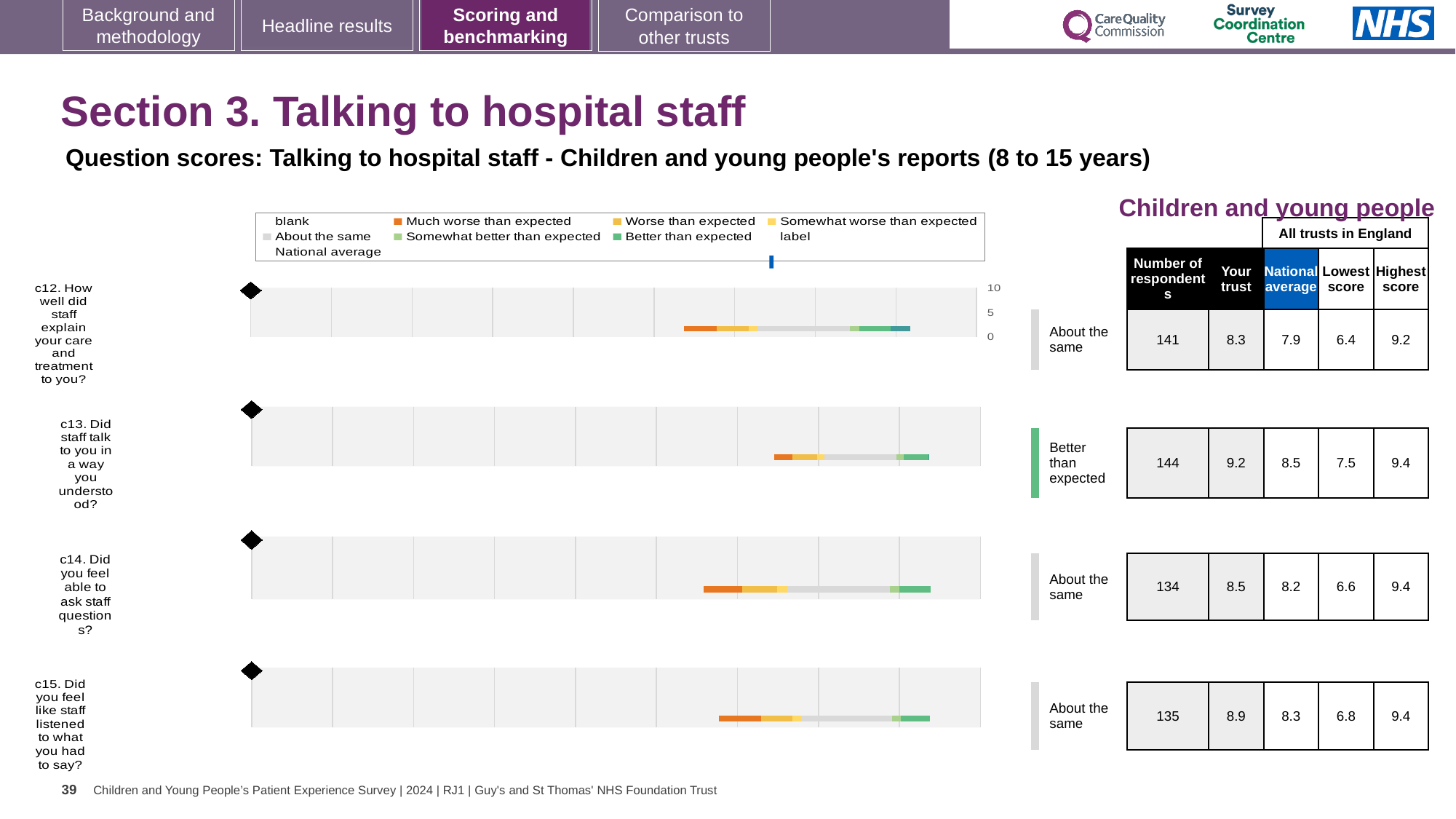
What is the highest score among all trusts in England for c12? 9.2 What kind of chart is used to show the question scores for c12 to c15? bar chart How many survey questions (c12 to c15) are plotted on the slide? 4 Which question has the highest 'Your trust' score? c13 What is the national average score for c12 (How well did staff explain your care and treatment to you?)? 7.9 How many respondents answered c15 (Did you feel like staff listened to what you had to say?)? 135 Which question has the lowest 'Your trust' score? c12 What is the 'Your trust' score for c13 (Did staff talk to you in a way you understood?)? 9.2 For c13, how much higher is the 'Your trust' score than the national average? 0.7 Which question is rated 'Better than expected'? c13 What is the lowest score among all trusts in England for c14? 6.6 For c14, which is larger: the 'Your trust' score or the national average? Your trust